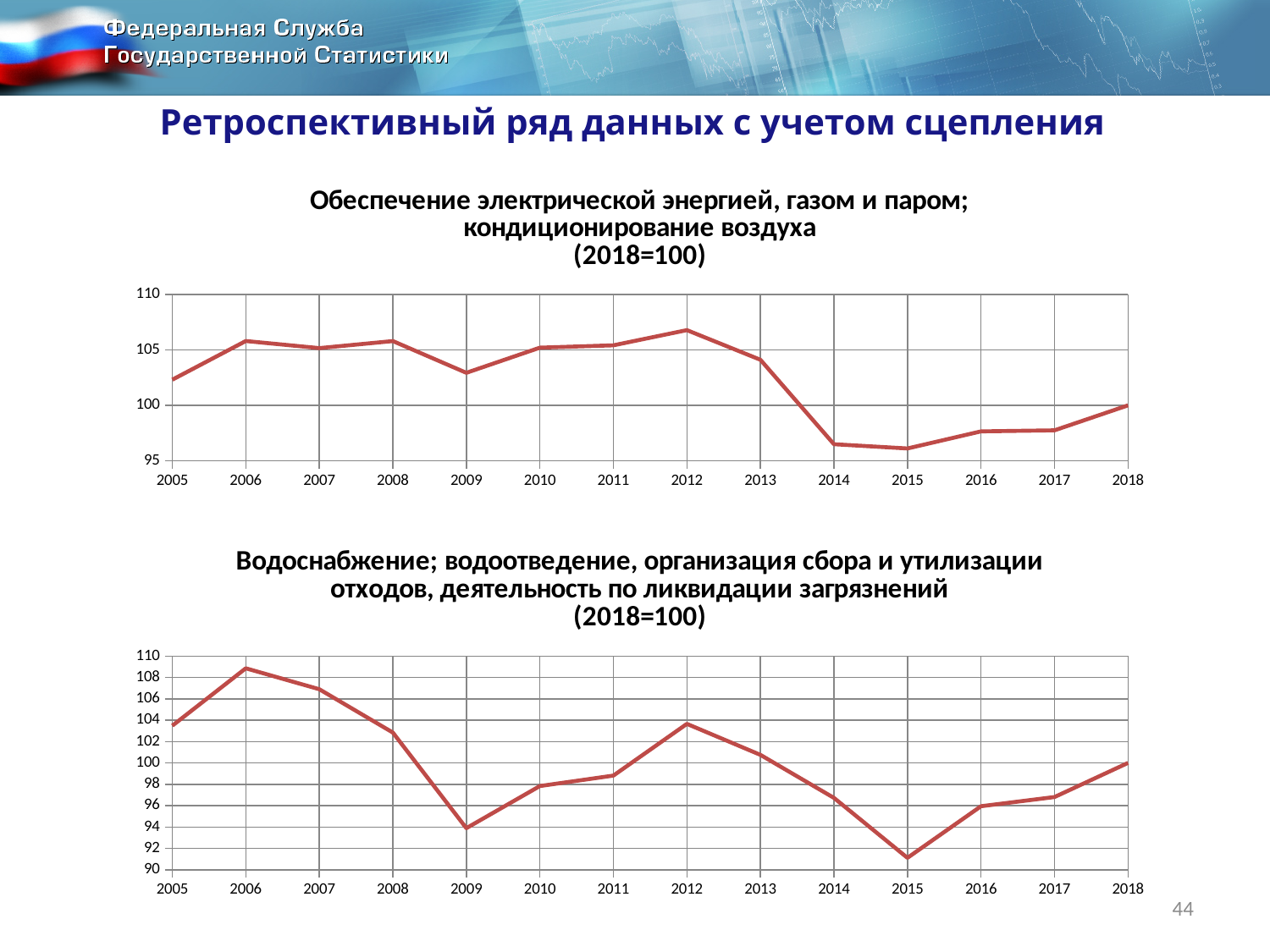
In the top chart (Обеспечение электрической энергией, газом и паром), is the value for 2008 greater or less than 105? greater How many years are plotted on the x axis of the top chart (Обеспечение электрической энергией, газом и паром)? 14 In the top chart (Обеспечение электрической энергией, газом и паром), is the value for 2014 greater or less than 100? less In the bottom chart (Водоснабжение; водоотведение), is the value for 2009 greater or less than 96? less In the top chart (Обеспечение электрической энергией, газом и паром), which year has the lowest value? 2015 In the bottom chart (Водоснабжение; водоотведение), which year has the highest value? 2006 In the bottom chart (Водоснабжение; водоотведение), which year has the larger value, 2012 or 2014? 2012 In the bottom chart (Водоснабжение; водоотведение), do the values rise or fall from 2006 to 2009? fall What type of chart is the top chart on the slide? line chart In the bottom chart (Водоснабжение; водоотведение), which year has the lowest value? 2015 In the top chart (Обеспечение электрической энергией, газом и паром), what is the value for 2018? 100 In the top chart (Обеспечение электрической энергией, газом и паром), which year has the highest value? 2012